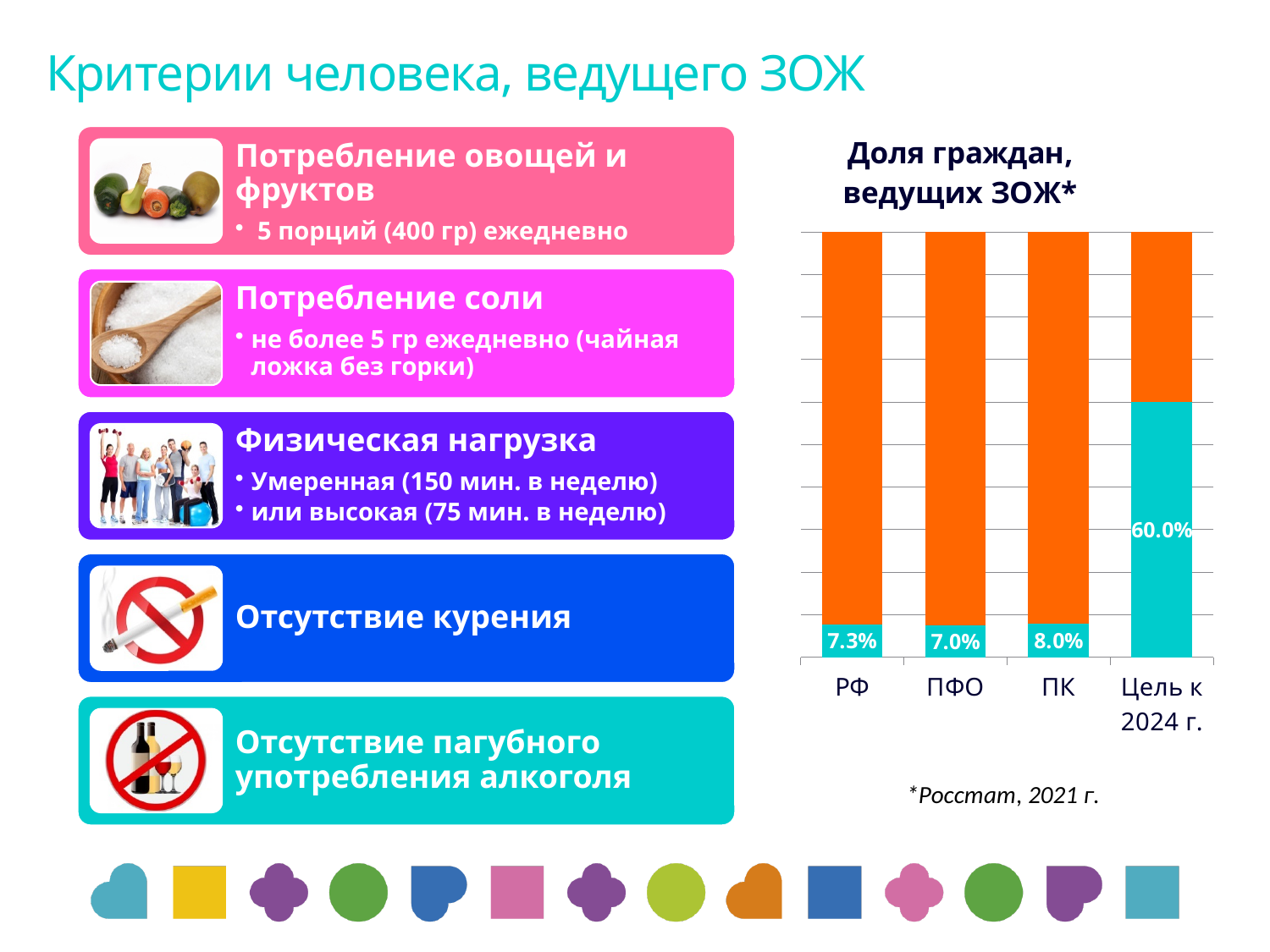
Which category has the lowest labelled value in the chart? ПФО How many categories are shown on the x axis of the chart? 4 What is the difference between the value for 'Цель к 2024 г.' and the value for РФ? 52.7% What is the difference between the value for ПК and the value for ПФО? 1.0% What is the value shown for ПК in the chart? 8.0% Which category has the highest labelled value in the chart? Цель к 2024 г. What is the value shown for 'Цель к 2024 г.' in the chart? 60.0% What is the title of the chart on the slide? Доля граждан, ведущих ЗОЖ* What kind of chart is shown on the slide? Stacked bar chart Which is larger, the value for ПК or the value for РФ? ПК What is the value shown for ПФО in the chart? 7.0% What is the value shown for РФ in the chart 'Доля граждан, ведущих ЗОЖ*'? 7.3%